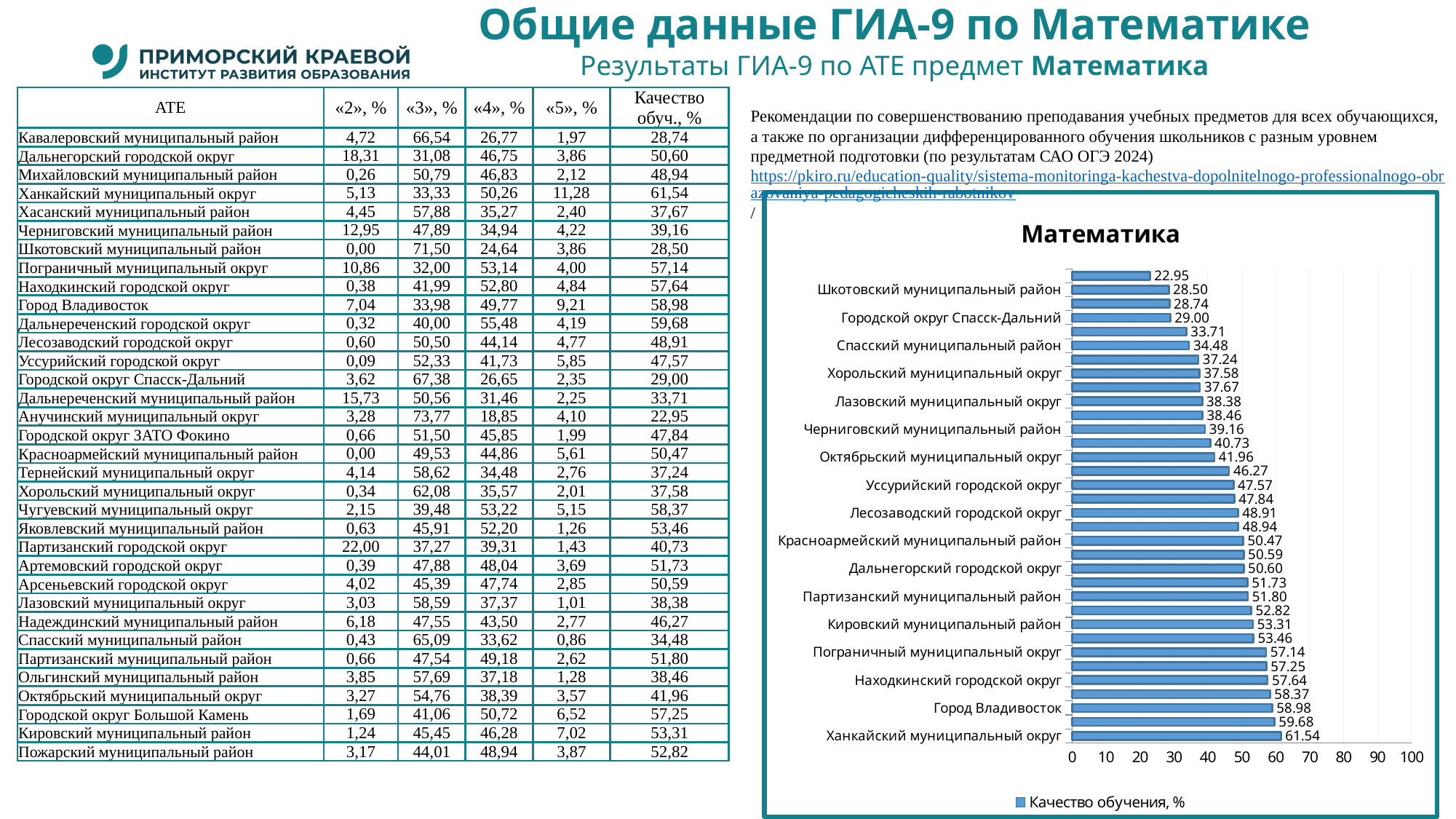
What is the difference between the values for Ханкайский муниципальный округ and Город Владивосток? 2.56 What is the value for Город Владивосток in the chart? 58.98 What is the value for Шкотовский муниципальный район in the chart? 28.50 What is the title of the chart? Математика Which has a larger value: Уссурийский городской округ or Лесозаводский городской округ? Лесозаводский городской округ Is the value for Кировский муниципальный район greater or less than 50? greater What kind of chart is shown on the slide? bar chart What is the value for Ханкайский муниципальный округ in the chart? 61.54 Which category has the highest value in the chart? Ханкайский муниципальный округ What series does the chart legend list? Качество обучения, % How many bars are plotted in the chart? 34 How many series does the chart legend list? 1